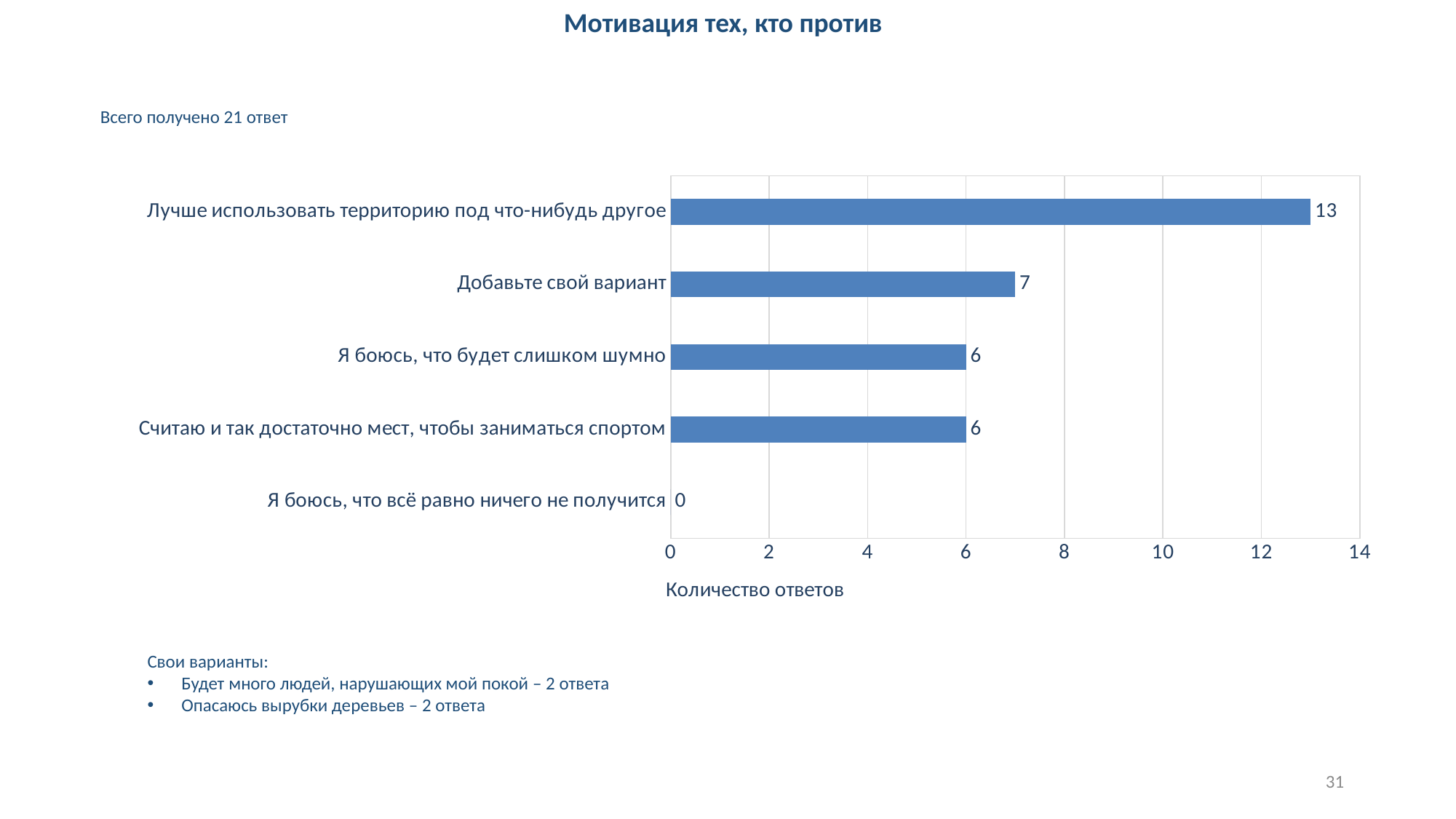
What is the title of the x axis? Количество ответов Which category has the lowest value? Я боюсь, что всё равно ничего не получится What is the value for "Я боюсь, что будет слишком шумно"? 6 What is the value for "Лучше использовать территорию под что-нибудь другое"? 13 Which is larger: the value for "Добавьте свой вариант" or the value for "Считаю и так достаточно мест, чтобы заниматься спортом"? Добавьте свой вариант How many categories are shown in the chart? 5 Is the value for "Лучше использовать территорию под что-нибудь другое" greater or less than 10? greater What is the value for "Я боюсь, что всё равно ничего не получится"? 0 What kind of chart is shown on the slide? bar chart What is the value for "Добавьте свой вариант"? 7 What is the difference between the values for "Лучше использовать территорию под что-нибудь другое" and "Добавьте свой вариант"? 6 Which category has the highest value? Лучше использовать территорию под что-нибудь другое